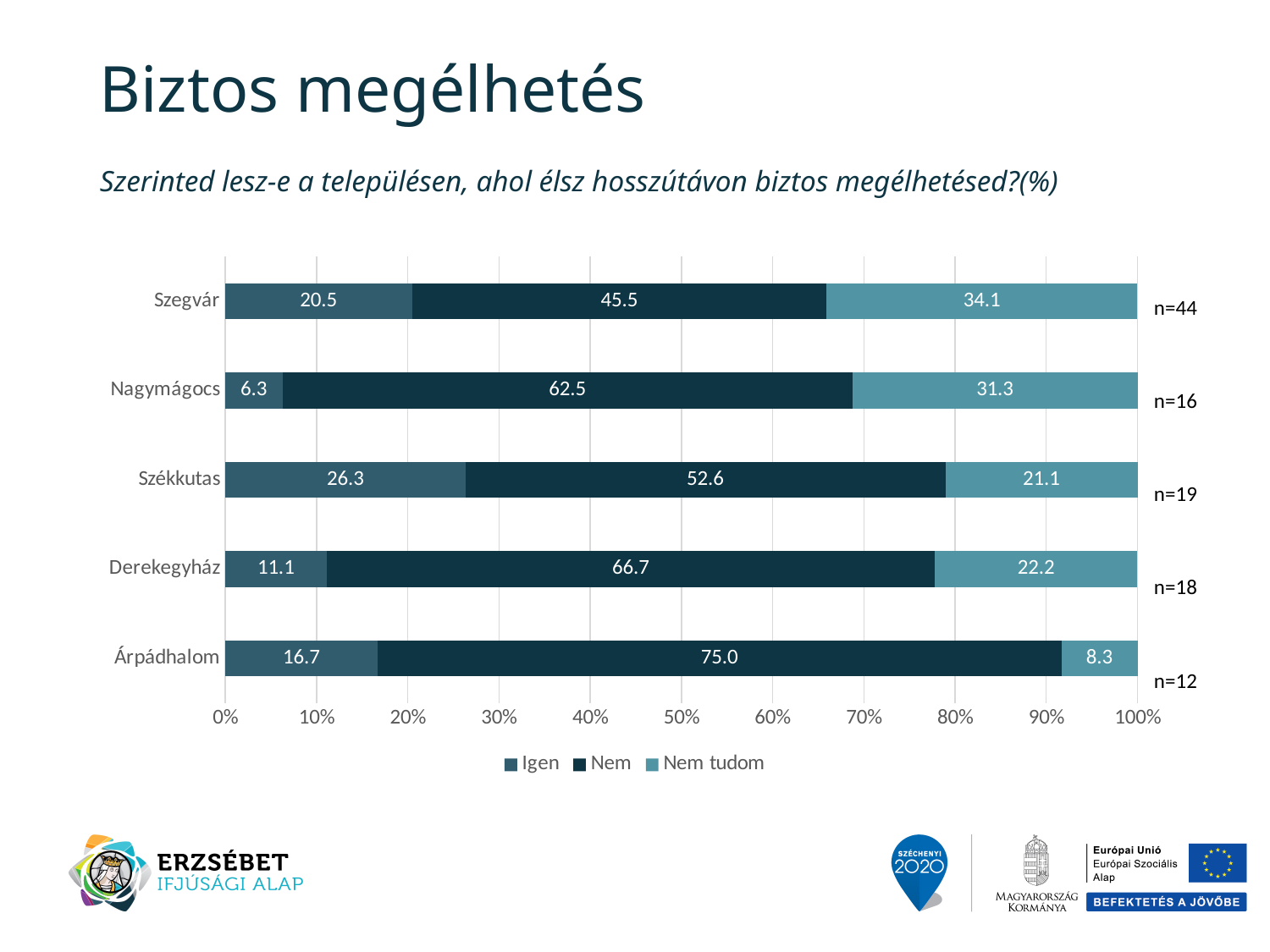
What are the three legend entries of the chart? Igen, Nem, Nem tudom What is the difference between the "Nem" values for Derekegyház and Szegvár? 21.2 What is the "Nem tudom" value for Árpádhalom? 8.3 Which settlement has the lowest "Igen" value? Nagymágocs Which is larger, the "Nem tudom" value for Szegvár or for Székkutas? Szegvár How many series does the legend list? 3 What is the "Nem" value for Nagymágocs? 62.5 What is the sample size (n) shown for Szegvár? n=44 What is the "Igen" value for Szegvár? 20.5 Which settlement has the highest "Nem" value? Árpádhalom What kind of chart is shown on the slide? Stacked bar chart How many settlements are shown on the chart? 5